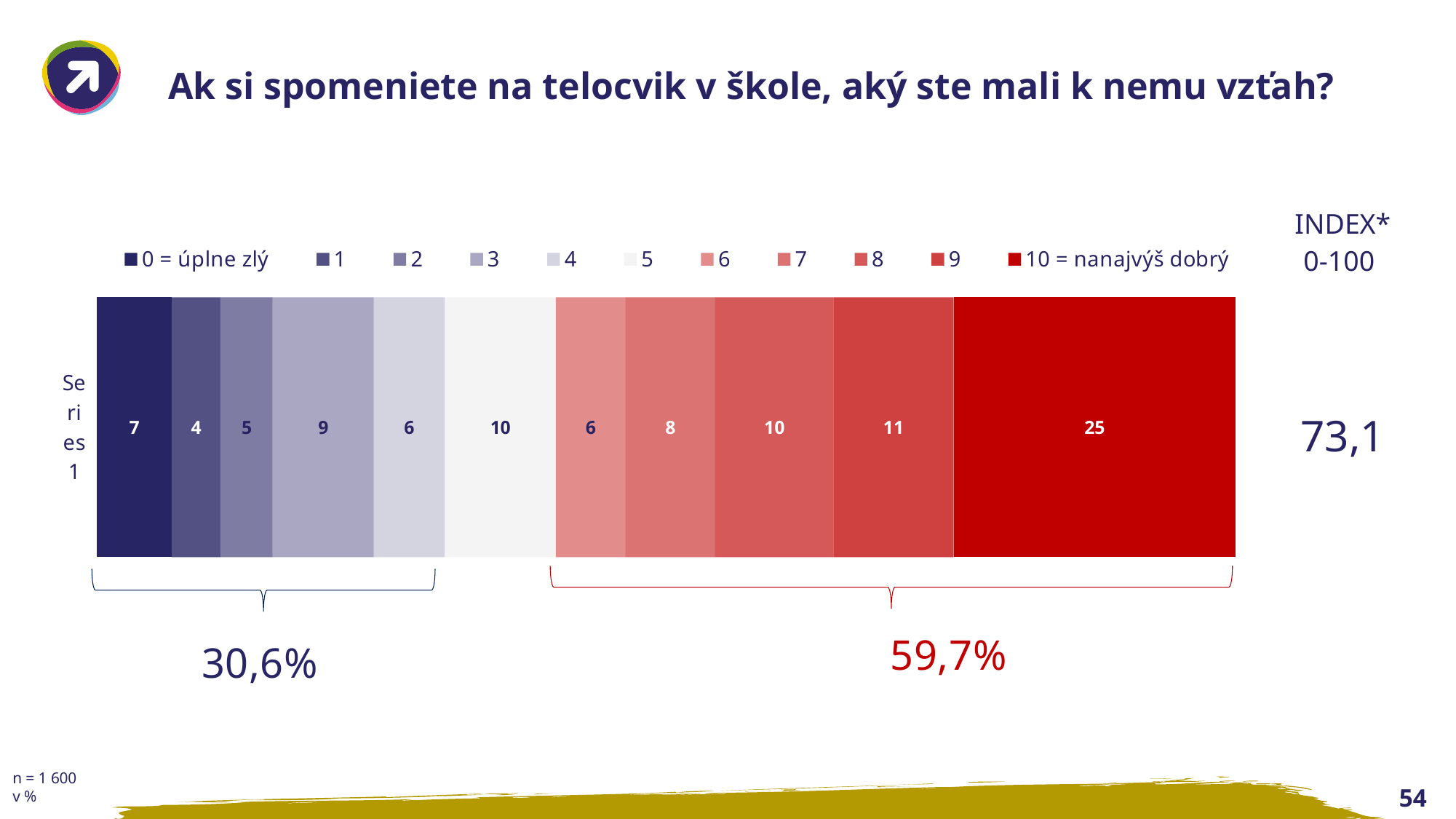
What is the value for segment 5? 10 What is the difference between the values for segment 10 and segment 9? 14 What is the value for the segment "0 = úplne zlý"? 7 How many series does the legend list? 11 What is the value for segment 9? 11 What type of chart is shown on the slide? stacked bar chart Which segment has the lowest value? 1 What is the value for the segment "10 = nanajvýš dobrý"? 25 What is the total of all segments in the stacked bar? 101 What INDEX value (0-100) is shown to the right of the chart? 73,1 Which is larger, the value for segment 3 or the value for segment 7? segment 3 Which segment has the highest value? 10 = nanajvýš dobrý